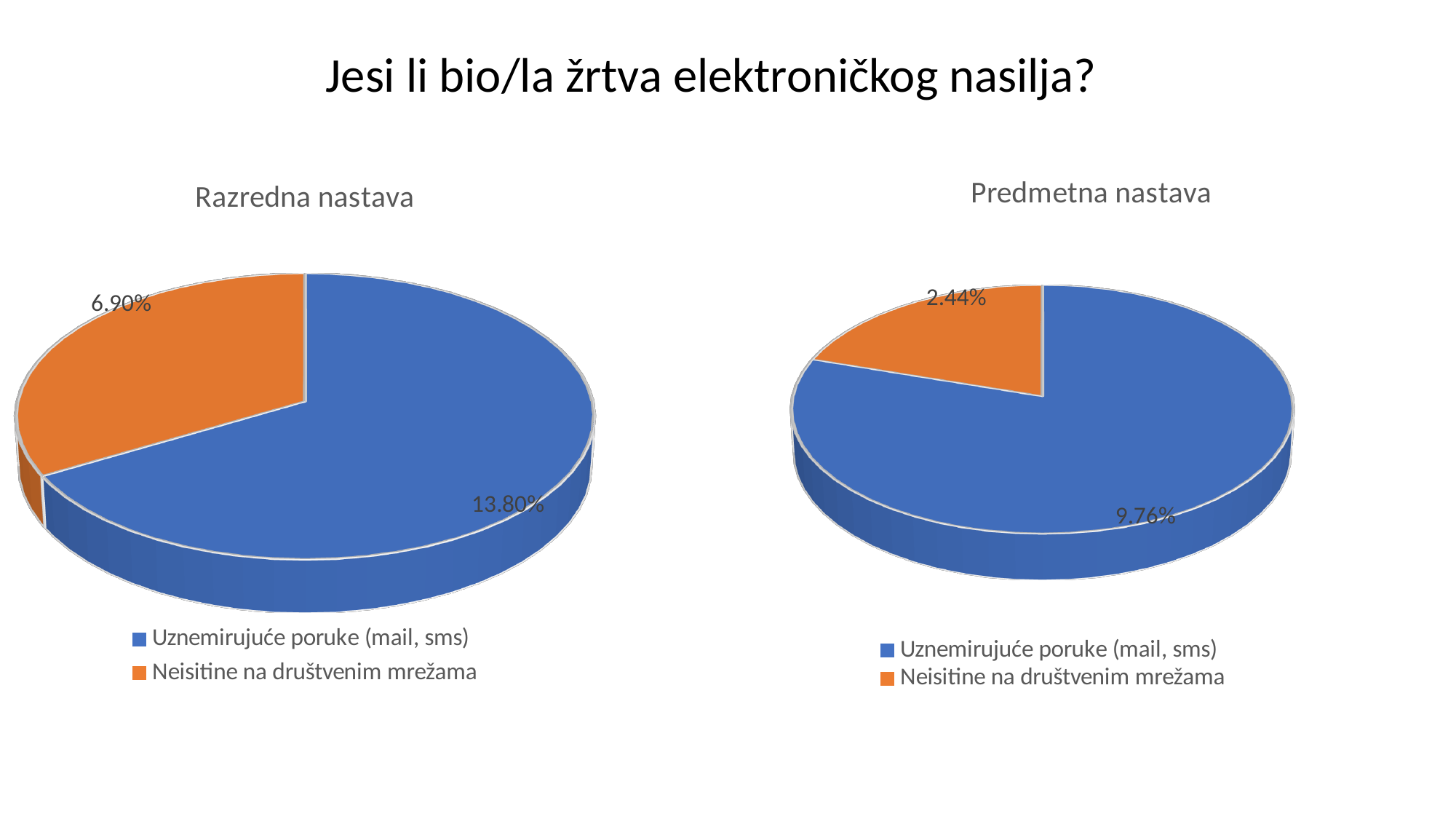
In the 'Predmetna nastava' chart, what is the difference between the values for 'Uznemirujuće poruke (mail, sms)' and 'Neisitine na društvenim mrežama'? 7.32% In the 'Razredna nastava' chart, what is the difference between the values for 'Uznemirujuće poruke (mail, sms)' and 'Neisitine na društvenim mrežama'? 6.90% Which is larger: the value for 'Neisitine na društvenim mrežama' in the 'Razredna nastava' chart or in the 'Predmetna nastava' chart? Razredna nastava How many categories does the 'Predmetna nastava' chart show? 2 In the 'Predmetna nastava' chart, what is the value for 'Neisitine na društvenim mrežama'? 2.44% In the 'Razredna nastava' chart, what is the value for 'Neisitine na društvenim mrežama'? 6.90% In the 'Razredna nastava' chart, what colour is the slice for 'Neisitine na društvenim mrežama'? orange In the 'Razredna nastava' chart, what is the value for 'Uznemirujuće poruke (mail, sms)'? 13.80% In the 'Razredna nastava' chart, which category has the largest slice? Uznemirujuće poruke (mail, sms) In the 'Predmetna nastava' chart, which category has the smallest slice? Neisitine na društvenim mrežama In the 'Predmetna nastava' chart, what is the value for 'Uznemirujuće poruke (mail, sms)'? 9.76% What type of chart is the 'Razredna nastava' chart? pie chart